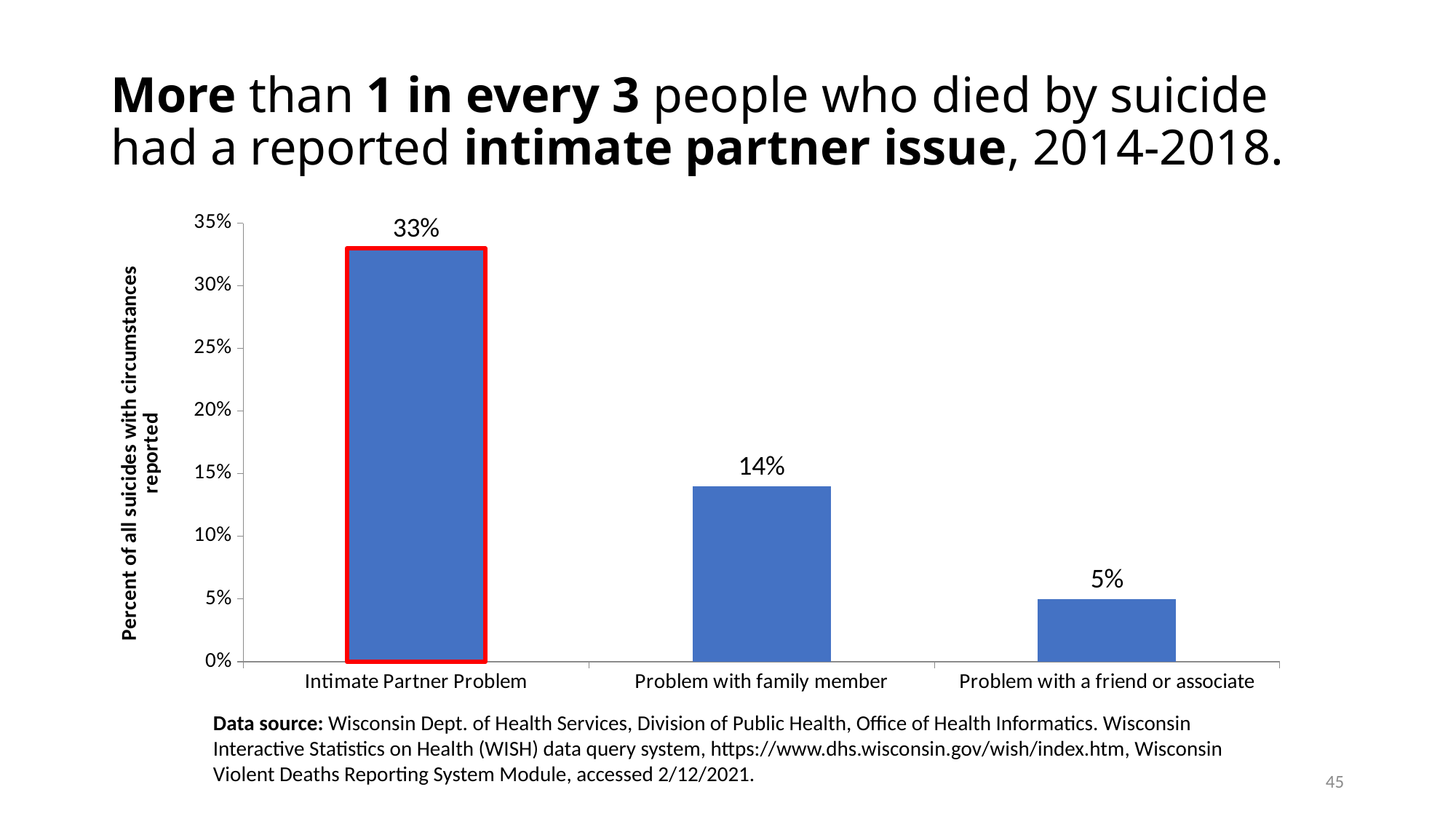
Is the value for Intimate Partner Problem greater or less than 30%? greater Which is larger, the value for Problem with family member or the value for Problem with a friend or associate? Problem with family member What kind of chart is shown on the slide? bar chart What is the value for Problem with a friend or associate? 5% How many categories are shown in the chart? 3 What is the value for Intimate Partner Problem? 33% Which category has the lowest value? Problem with a friend or associate What is the difference between the values for Problem with family member and Problem with a friend or associate? 9% Which category has the highest value? Intimate Partner Problem What is the label of the vertical axis? Percent of all suicides with circumstances reported What is the difference between the values for Intimate Partner Problem and Problem with family member? 19% What is the value for Problem with family member? 14%